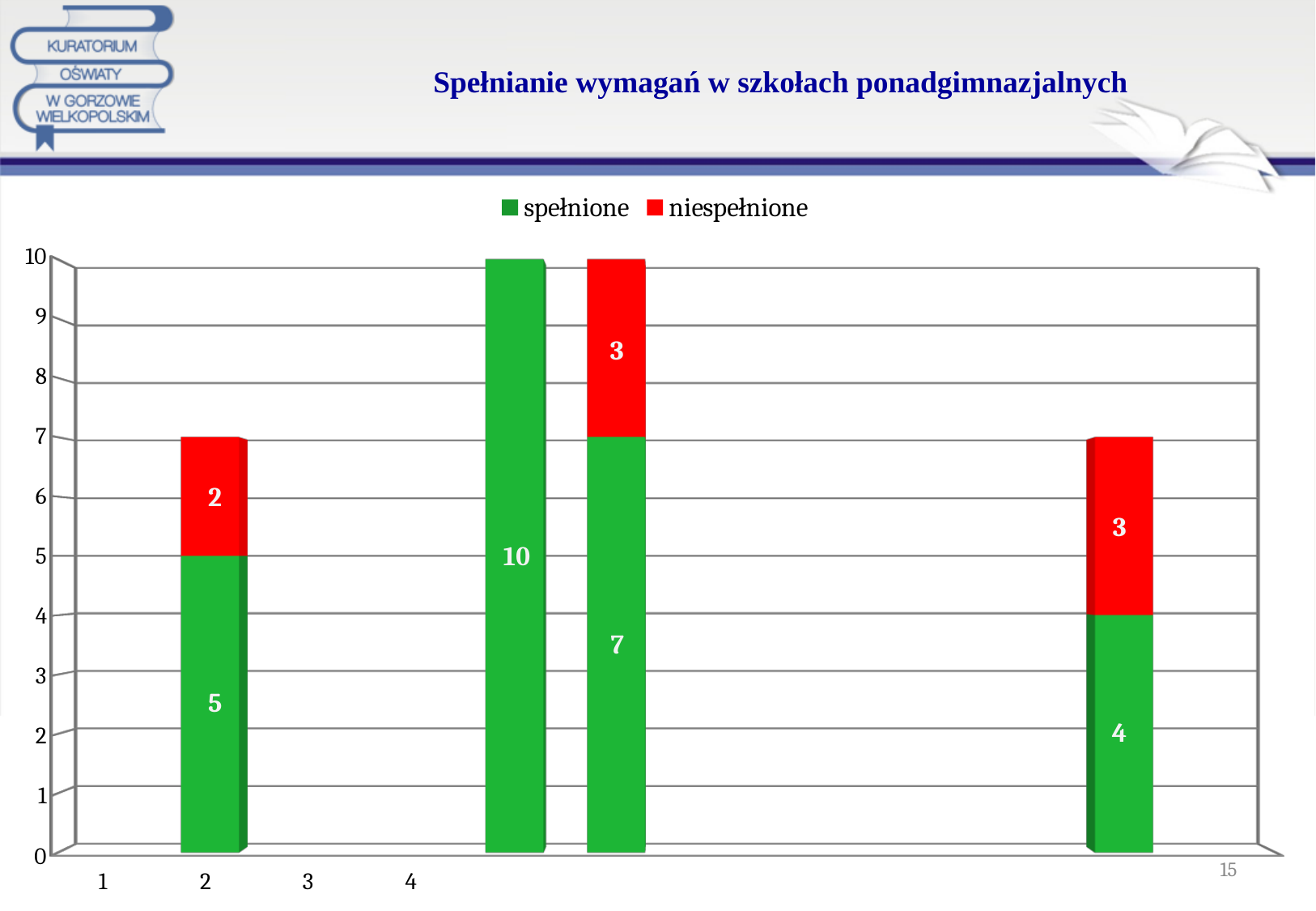
How many series does the legend list? 2 What is the total of the third bar from the left (spełnione plus niespełnione)? 10 How many stacked bars are plotted in the chart? 4 What kind of chart is shown on the slide? bar chart What is the spełnione value of the leftmost bar? 5 What is the spełnione value of the second bar from the left? 10 Which bar has the highest spełnione value? the second bar from the left What is the niespełnione value of the third bar from the left? 3 What is the title of the chart? Spełnianie wymagań w szkołach ponadgimnazjalnych What are the two series named in the legend? spełnione, niespełnione What is the niespełnione value of the leftmost bar? 2 What is the difference between the spełnione and niespełnione values in the rightmost bar? 1